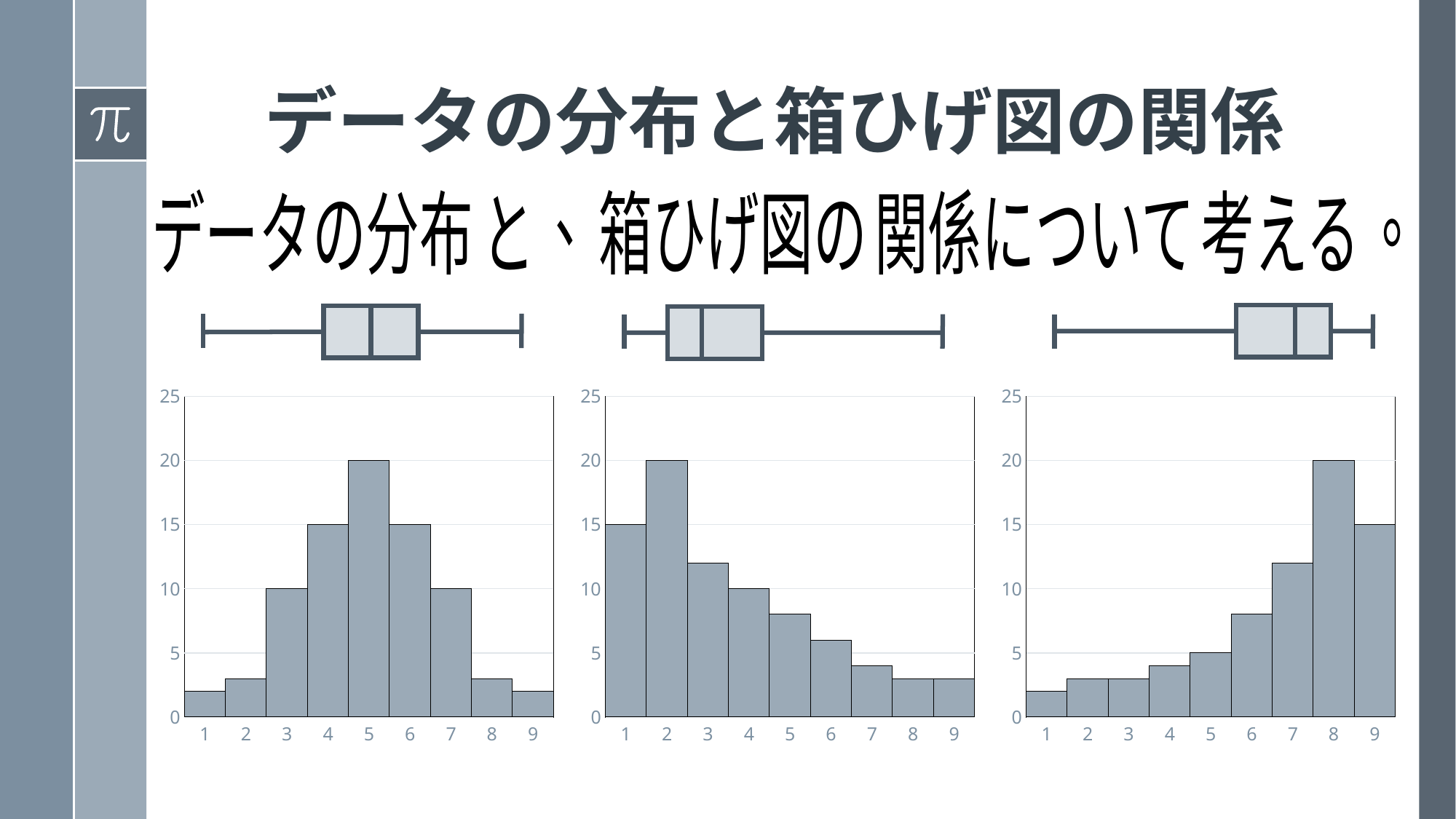
In the middle chart, which category has the highest bar? 2 In the left chart, what is the difference between the values for category 5 and category 3? 10 In the middle chart, which is larger, the value for category 3 or the value for category 6? category 3 In the middle chart, what is the value for category 1? 15 What kind of chart is the right chart? bar chart How many categories are shown on the x axis of the left chart? 9 In the right chart, is the value for category 7 greater or less than 10? greater In the right chart, what is the value for category 9? 15 In the left chart, what is the value for category 5? 20 In the right chart, which category has the highest bar? 8 In the middle chart, is the value for category 7 greater or less than 5? less In the left chart, which category has the highest bar? 5